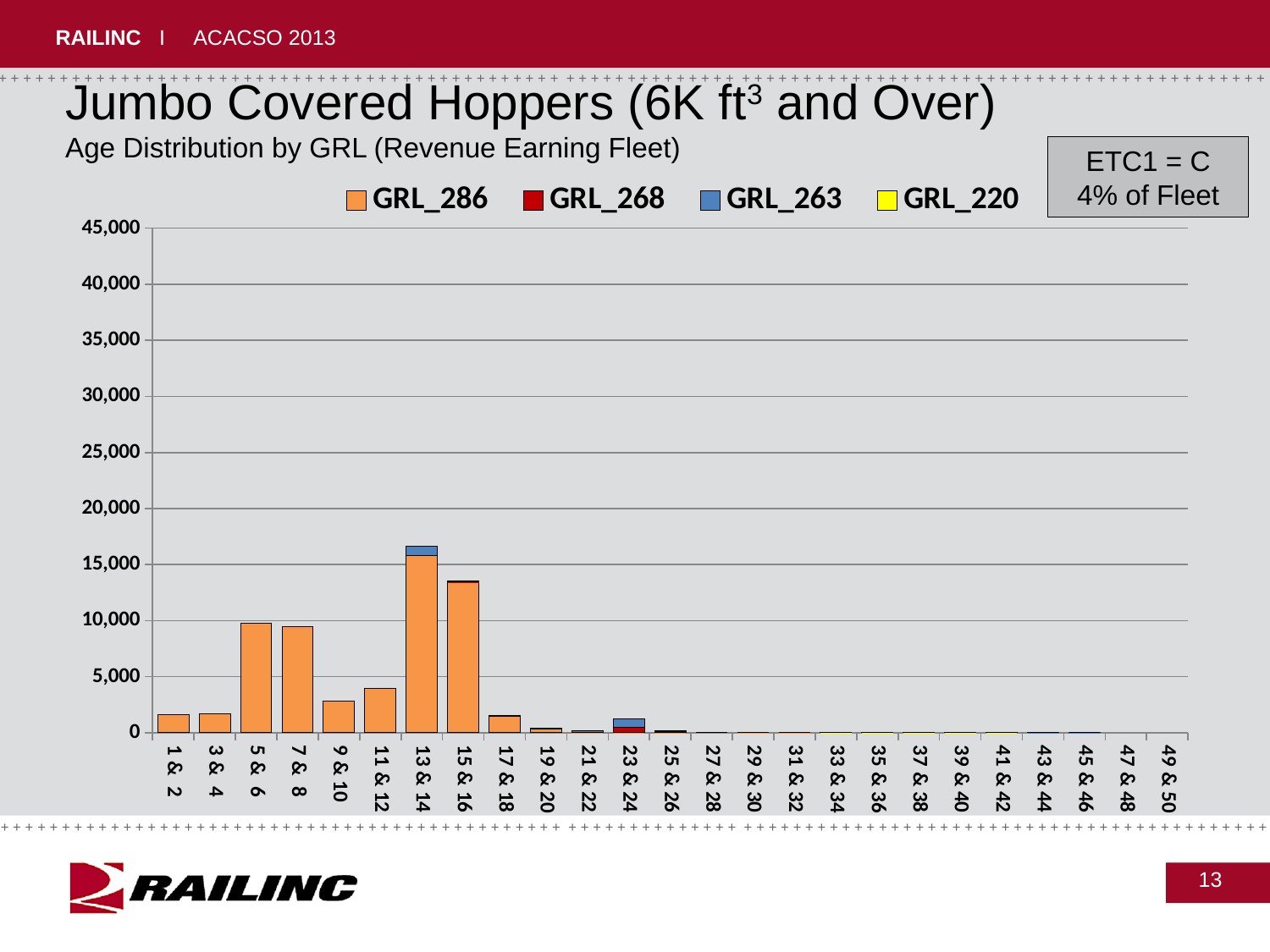
Is the value for the 11 & 12 age group greater or less than 5,000? less Which bar is taller, 13 & 14 or 15 & 16? 13 & 14 How many series does the legend list? 4 Is the value for the 7 & 8 age group greater or less than 10,000? less What kind of chart is shown on the slide? Stacked bar chart Is the total value for the 15 & 16 age group greater or less than 15,000? less Which series is shown in yellow in the legend? GRL_220 Do the bar heights rise or fall from the 13 & 14 age group to the 19 & 20 age group? fall Which age group has the tallest bar? 13 & 14 How many age-group categories are shown on the x axis? 25 Which bar is taller, 9 & 10 or 11 & 12? 11 & 12